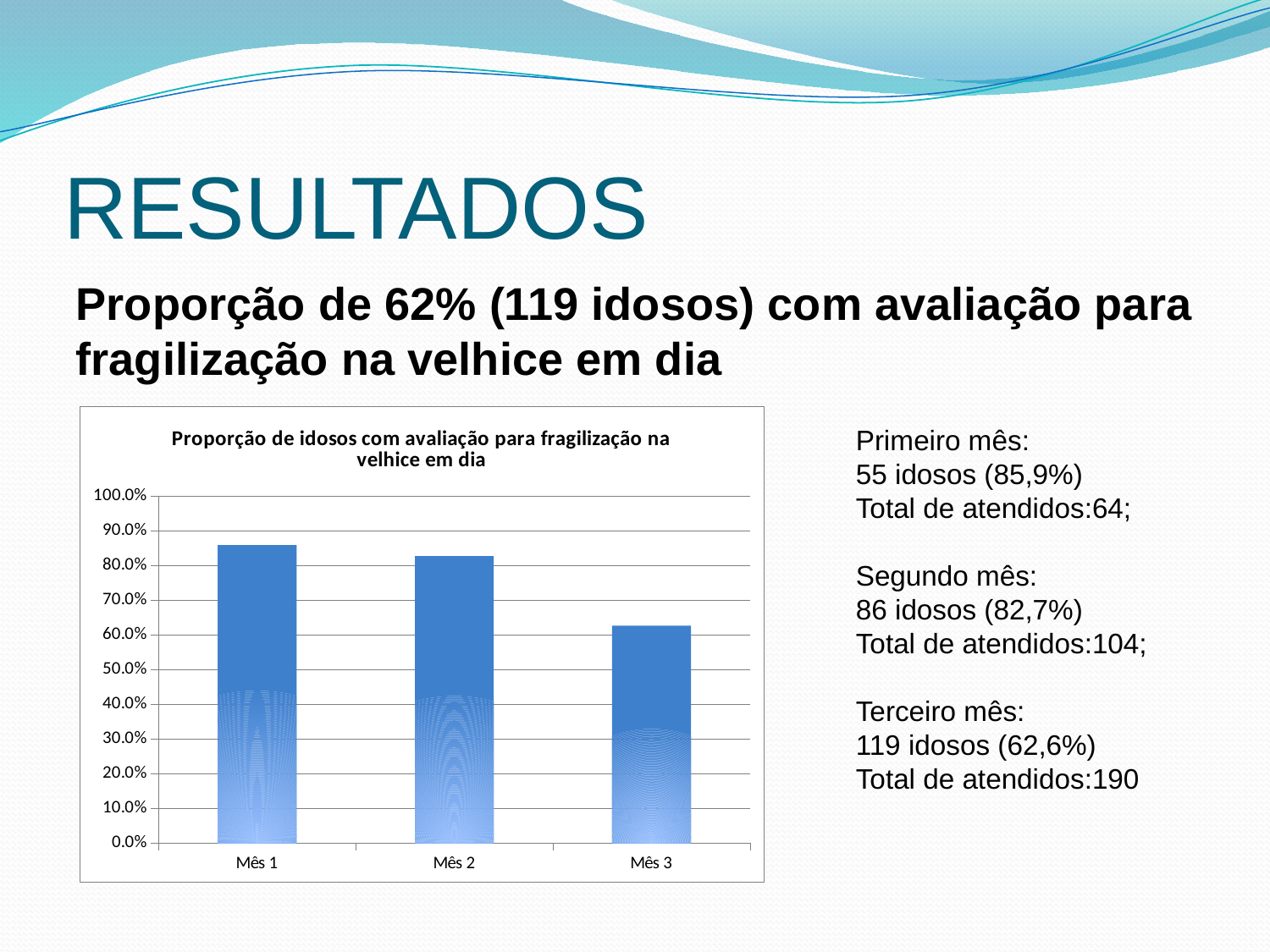
What is the maximum value shown on the chart's y axis? 100.0% What is the title of the chart? Proporção de idosos com avaliação para fragilização na velhice em dia What kind of chart is shown on the slide? bar chart Is the value for Mês 3 greater or less than 50.0%? greater How many months (categories) are plotted on the x axis of the chart? 3 Is the value for Mês 2 greater or less than 90.0%? less Which month has the lowest bar in the chart? Mês 3 Is the value for Mês 3 greater or less than 70.0%? less Do the values rise or fall from Mês 1 to Mês 3? fall Is the bar for Mês 2 taller or shorter than the bar for Mês 3? taller Which month has the highest bar in the chart? Mês 1